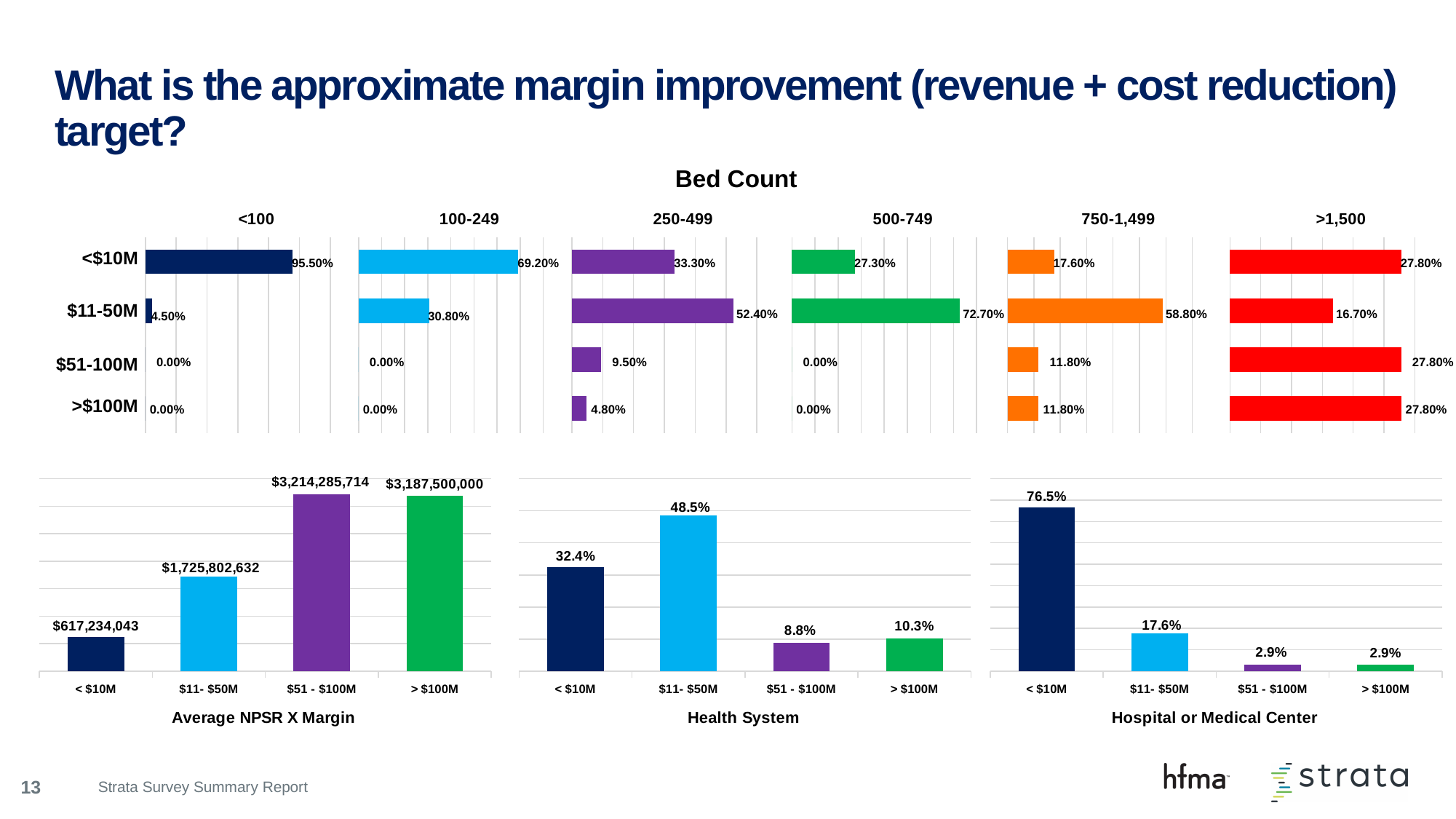
In the Bed Count chart, how many bed count columns are shown? 6 In the Average NPSR X Margin chart, what is the value for $11- $50M? $1,725,802,632 In the Average NPSR X Margin chart, which category has the lowest value? < $10M What kind of chart is the Hospital or Medical Center chart? Bar chart In the Bed Count chart, which margin target has the highest value in the 750-1,499 bed count column? $11-50M In the Hospital or Medical Center chart, what is the value for < $10M? 76.5% In the Bed Count chart, what is the value for <$10M in the <100 bed count column? 95.50% In the Health System chart, which category has the highest value? $11- $50M In the Bed Count chart, which is larger in the 250-499 column: the value for $51-100M or the value for >$100M? $51-100M In the Bed Count chart, what is the difference between the <$10M and $11-50M values in the 100-249 bed count column? 38.40% In the Health System chart, what is the difference between the > $100M and $51 - $100M values? 1.5% In the Bed Count chart, what is the value for $11-50M in the 500-749 bed count column? 72.70%